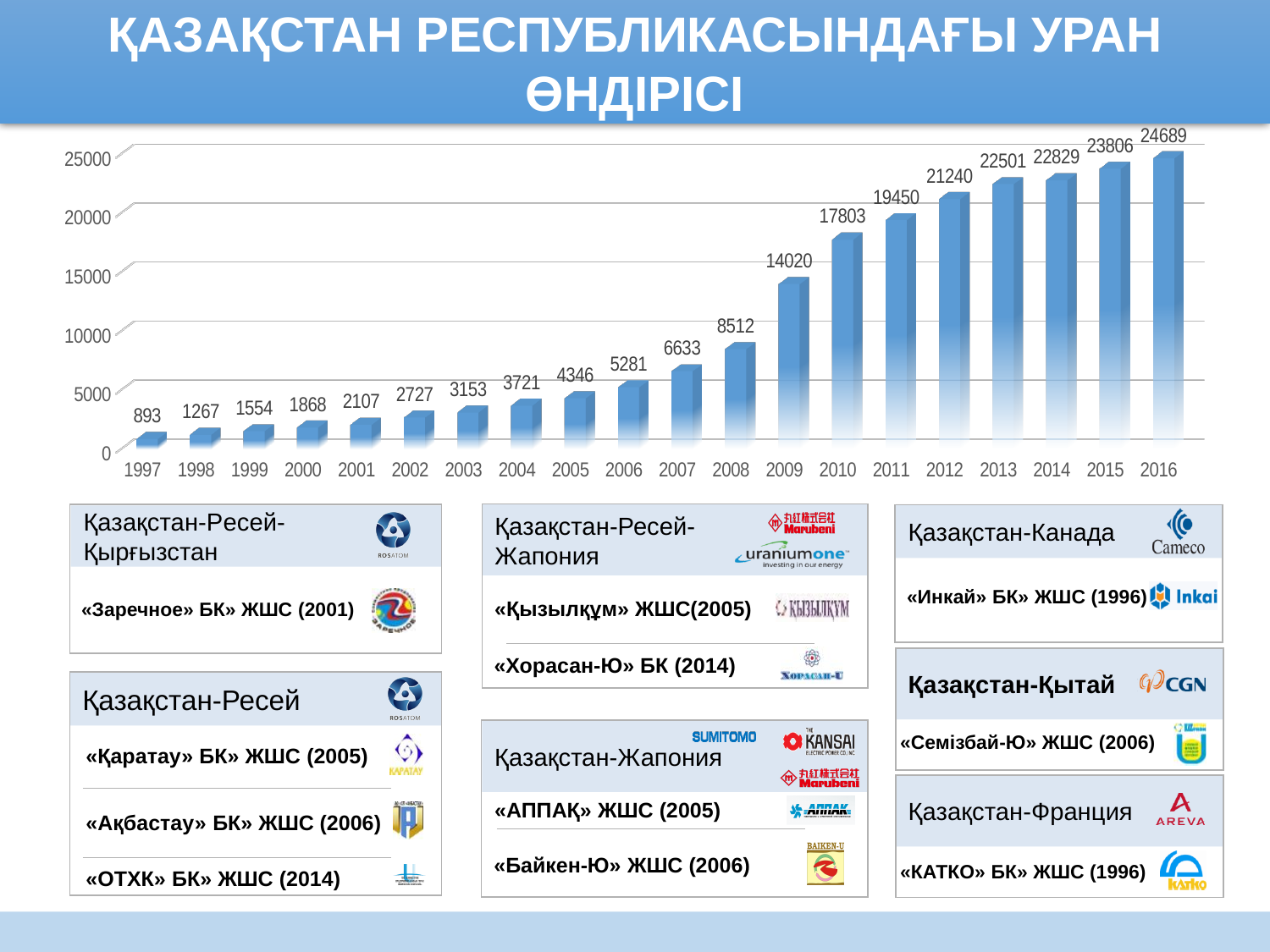
Which is larger, the value for 2008 or the value for 2007? 2008 What is the value shown for 2005? 4346 Which year has the highest value? 2016 How many years are shown on the x axis? 20 What is the value shown for 1997? 893 Which year has the lowest value? 1997 What is the value shown for 2016? 24689 What kind of chart is shown on the slide? bar chart What is the difference between the values for 2010 and 2009? 3783 Is the value for 2012 greater or less than 20000? greater What is the value shown for 2009? 14020 What is the difference between the values for 2016 and 2015? 883